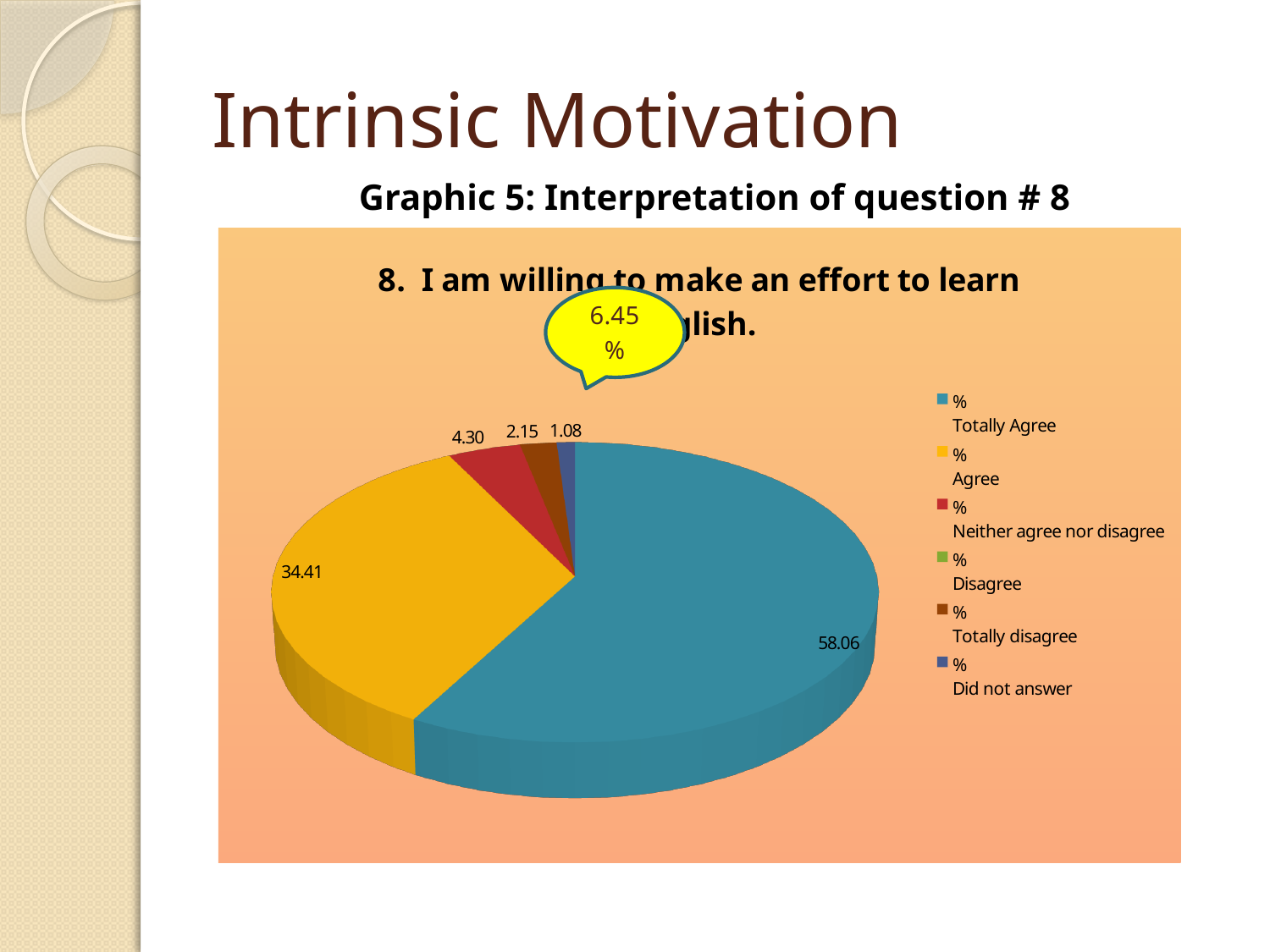
What is the value shown for Neither agree nor disagree? 4.30 What is the value shown for Did not answer? 1.08 Which category has the largest slice of the pie? Totally Agree Which is larger, the value for Neither agree nor disagree or the value for Totally disagree? Neither agree nor disagree What is the value shown for Totally Agree? 58.06 What is the value shown for Agree? 34.41 What type of chart is shown on the slide? pie chart What value is shown in the yellow callout bubble above the pie? 6.45 % What is the difference between the values for Totally Agree and Agree? 23.65 Which labelled category has the smallest slice of the pie? Did not answer How many entries does the legend list? 6 What is the value shown for Totally disagree? 2.15